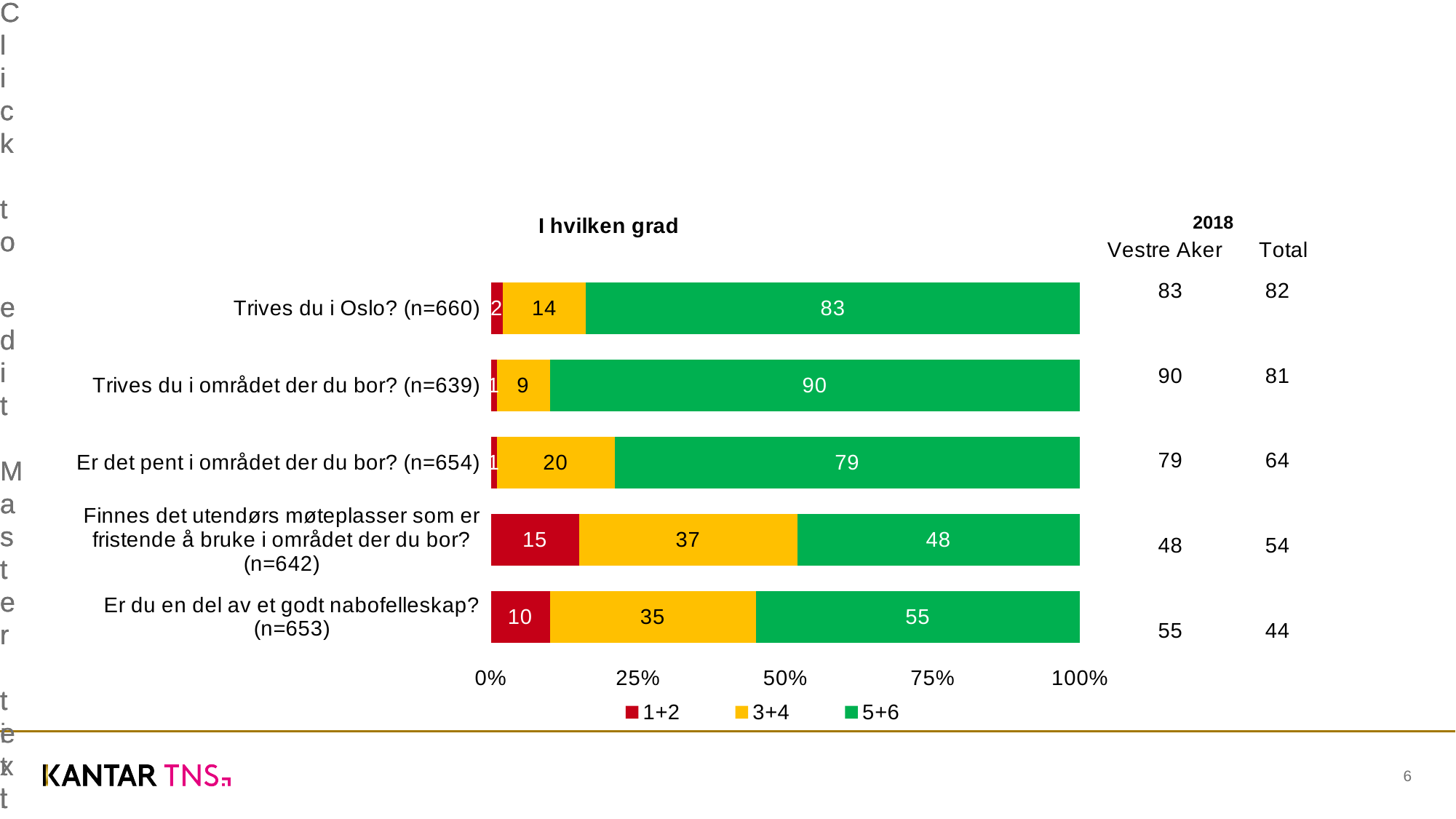
What is the 1+2 value for "Er du en del av et godt nabofelleskap? (n=653)"? 10 How many series does the legend list? 3 Which has a larger 1+2 value: "Finnes det utendørs møteplasser som er fristende å bruke i området der du bor? (n=642)" or "Er du en del av et godt nabofelleskap? (n=653)"? Finnes det utendørs møteplasser som er fristende å bruke i området der du bor? (n=642) What is the 5+6 value for "Trives du i området der du bor? (n=639)"? 90 What is the 3+4 value for "Finnes det utendørs møteplasser som er fristende å bruke i området der du bor? (n=642)"? 37 Which category has the highest 5+6 value? Trives du i området der du bor? (n=639) How many categories (questions) are plotted in the chart? 5 What is the title of the chart? I hvilken grad What kind of chart is shown on the slide? stacked bar chart What is the difference between the 5+6 values for "Trives du i Oslo? (n=660)" and "Er det pent i området der du bor? (n=654)"? 4 Which colour represents the 5+6 series in the chart? green Which category has the lowest 5+6 value? Finnes det utendørs møteplasser som er fristende å bruke i området der du bor? (n=642)